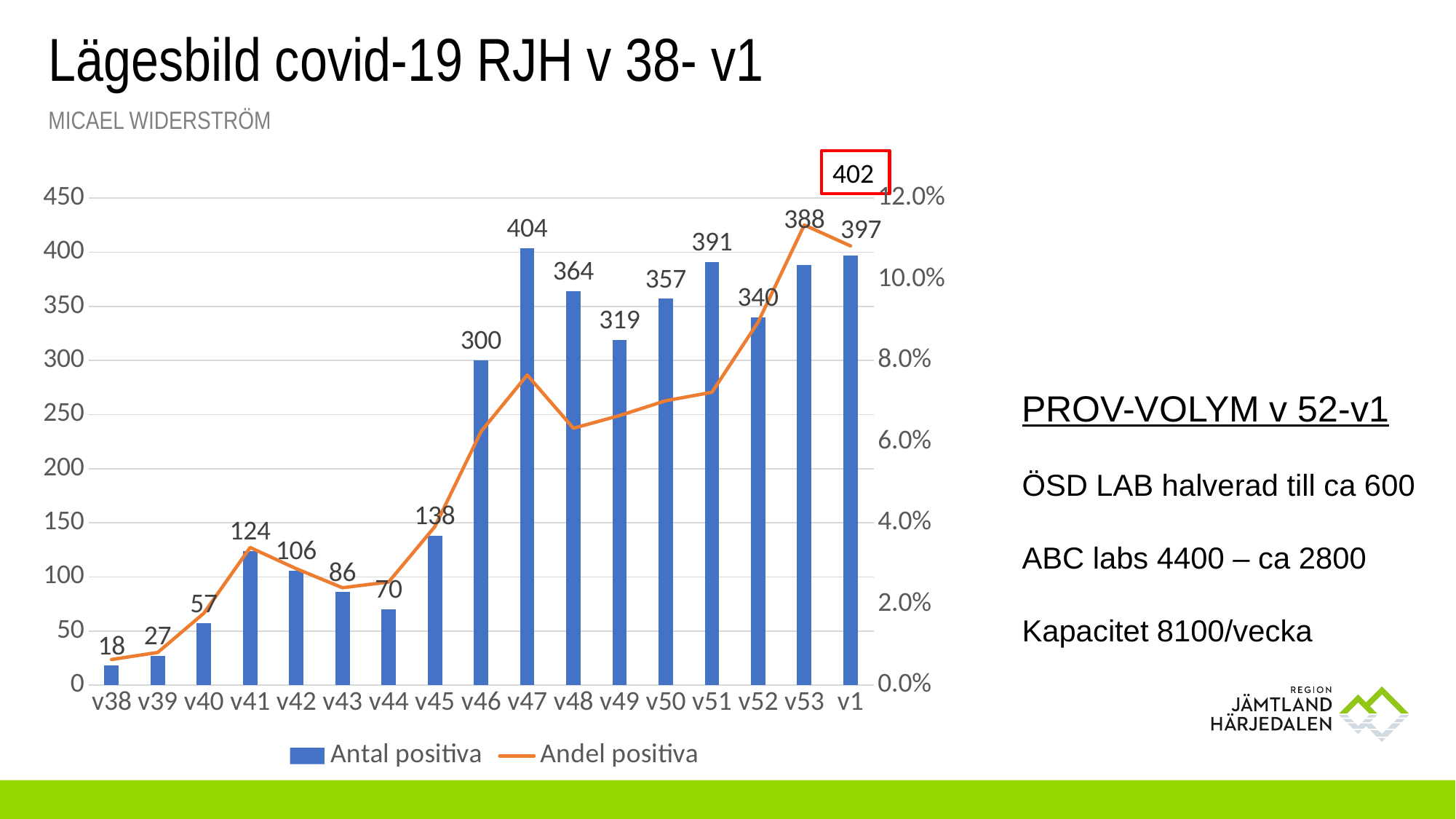
How many series does the legend list? 2 Which week has a larger Antal positiva, v51 or v52? v51 How many weeks are shown on the x axis of the chart? 17 What is the value of Antal positiva for v41? 124 Is the Andel positiva value for v53 greater or less than 10.0%? greater Which week has the lowest Antal positiva? v38 Is the Andel positiva value for v38 greater or less than 2.0%? less Which week has the highest Antal positiva? v47 What is the difference in Antal positiva between v47 and v48? 40 What is the value of Antal positiva for v46? 300 What kind of chart is shown on the slide? Combined bar and line chart Does Antal positiva rise or fall from v38 to v47? Rise